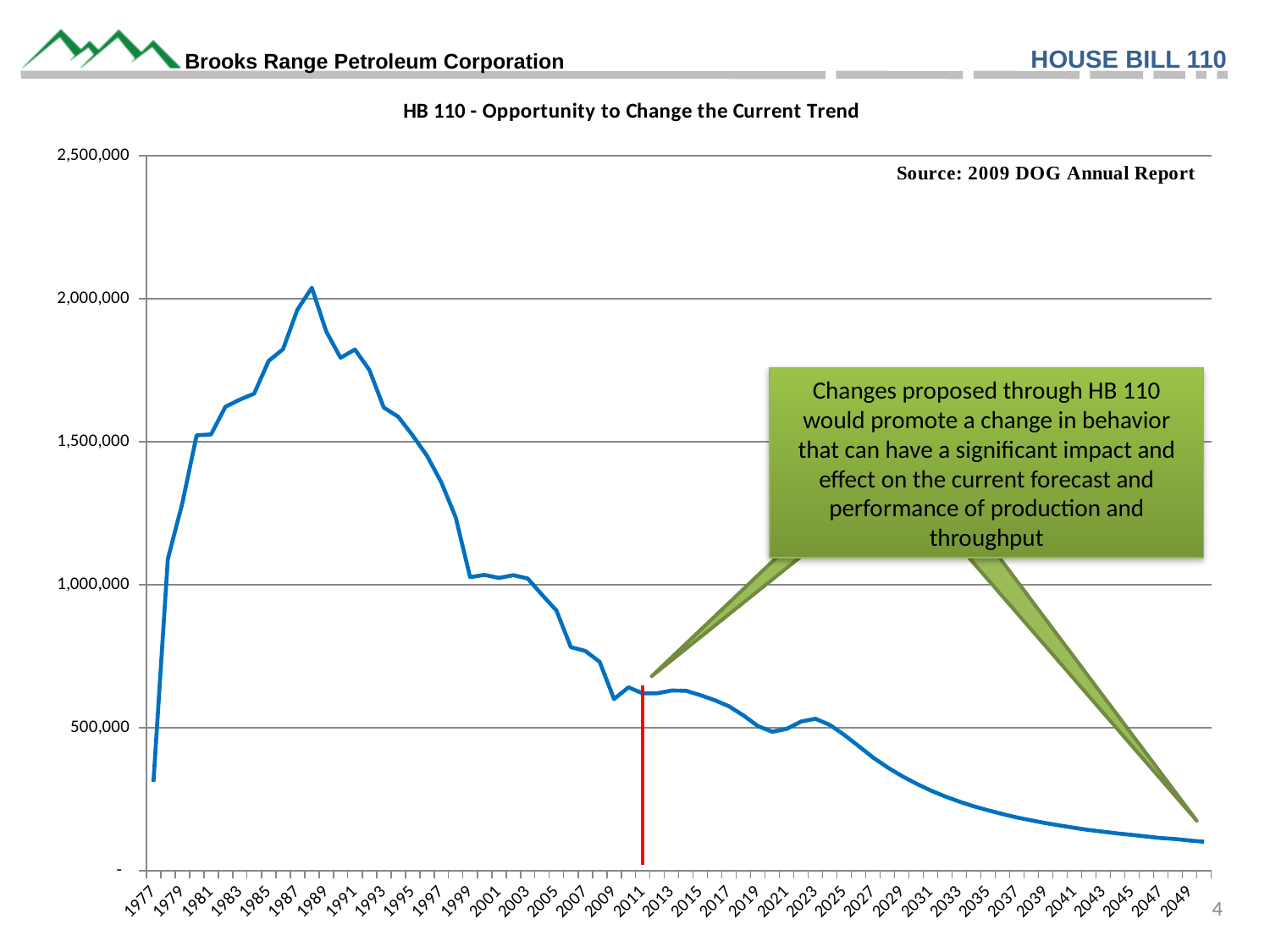
What source is cited on the chart? 2009 DOG Annual Report Is the value for 1989 greater or less than 1,500,000? greater What is the title of the chart? HB 110 - Opportunity to Change the Current Trend Which year has the larger value, 1985 or 2005? 1985 Which year has the larger value, 1981 or 2011? 1981 What kind of chart is shown on the slide? Line chart Is the value for 2031 greater or less than 500,000? less Is the value for 1977 greater or less than 500,000? less Do the values rise or fall along the x axis from 2025 to 2049? fall What is the first year shown on the x axis? 1977